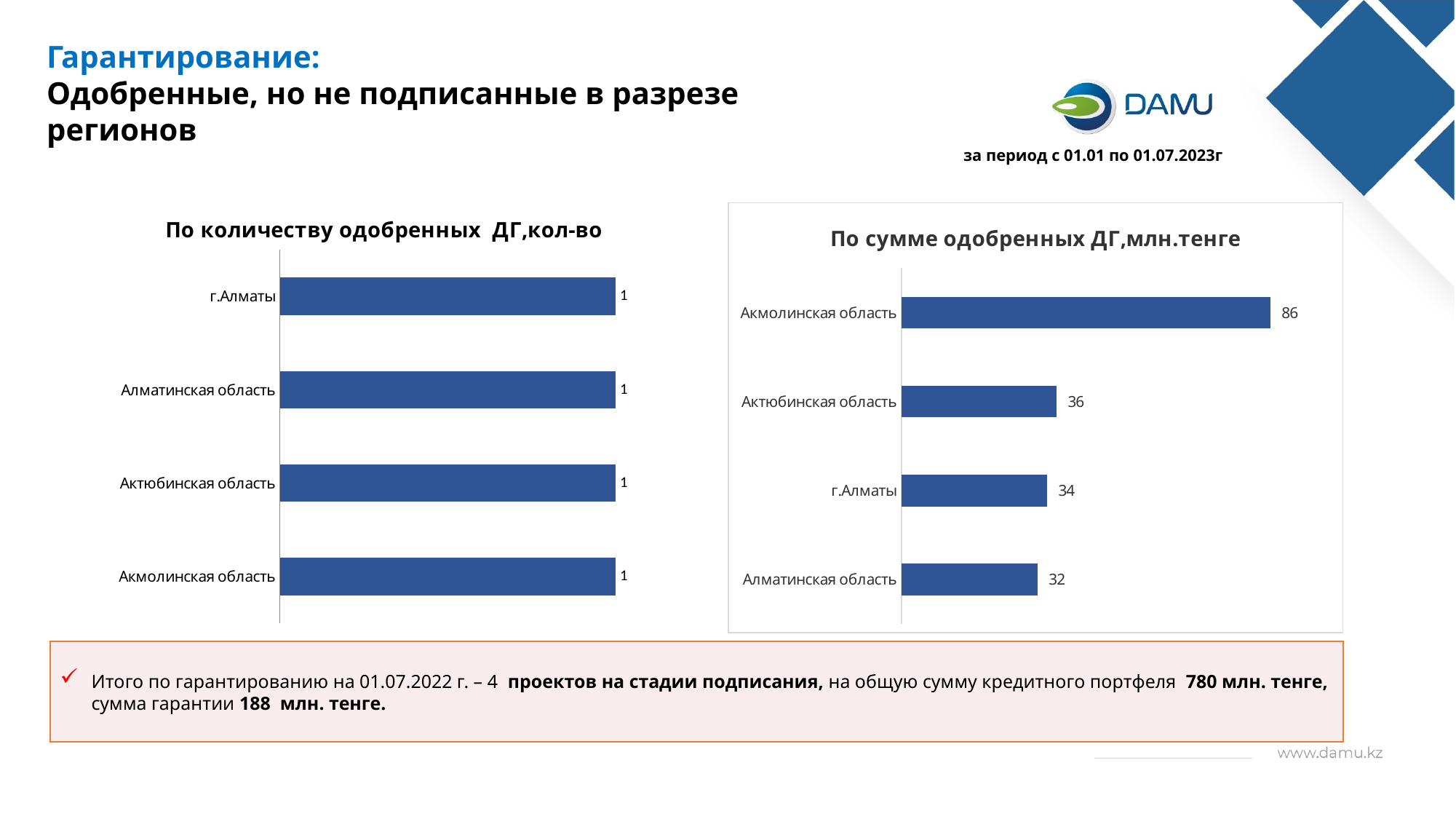
What is the title of the chart on the left side of the slide? По количеству одобренных ДГ,кол-во In the chart 'По сумме одобренных ДГ,млн.тенге', what is the difference between Акмолинская область and Актюбинская область? 50 In the chart 'По сумме одобренных ДГ,млн.тенге', what is the value for г.Алматы? 34 In the chart 'По количеству одобренных ДГ,кол-во', what is the value for г.Алматы? 1 How many regions are shown in the chart 'По количеству одобренных ДГ,кол-во'? 4 What type of chart is 'По сумме одобренных ДГ,млн.тенге'? Bar chart In the chart 'По сумме одобренных ДГ,млн.тенге', which region has the lowest value? Алматинская область In the chart 'По сумме одобренных ДГ,млн.тенге', which is larger: Акмолинская область or г.Алматы? Акмолинская область In the chart 'По сумме одобренных ДГ,млн.тенге', what is the value for Акмолинская область? 86 In the chart 'По сумме одобренных ДГ,млн.тенге', which region has the highest value? Акмолинская область In the chart 'По сумме одобренных ДГ,млн.тенге', what is the value for Алматинская область? 32 In the chart 'По сумме одобренных ДГ,млн.тенге', what is the value for Актюбинская область? 36